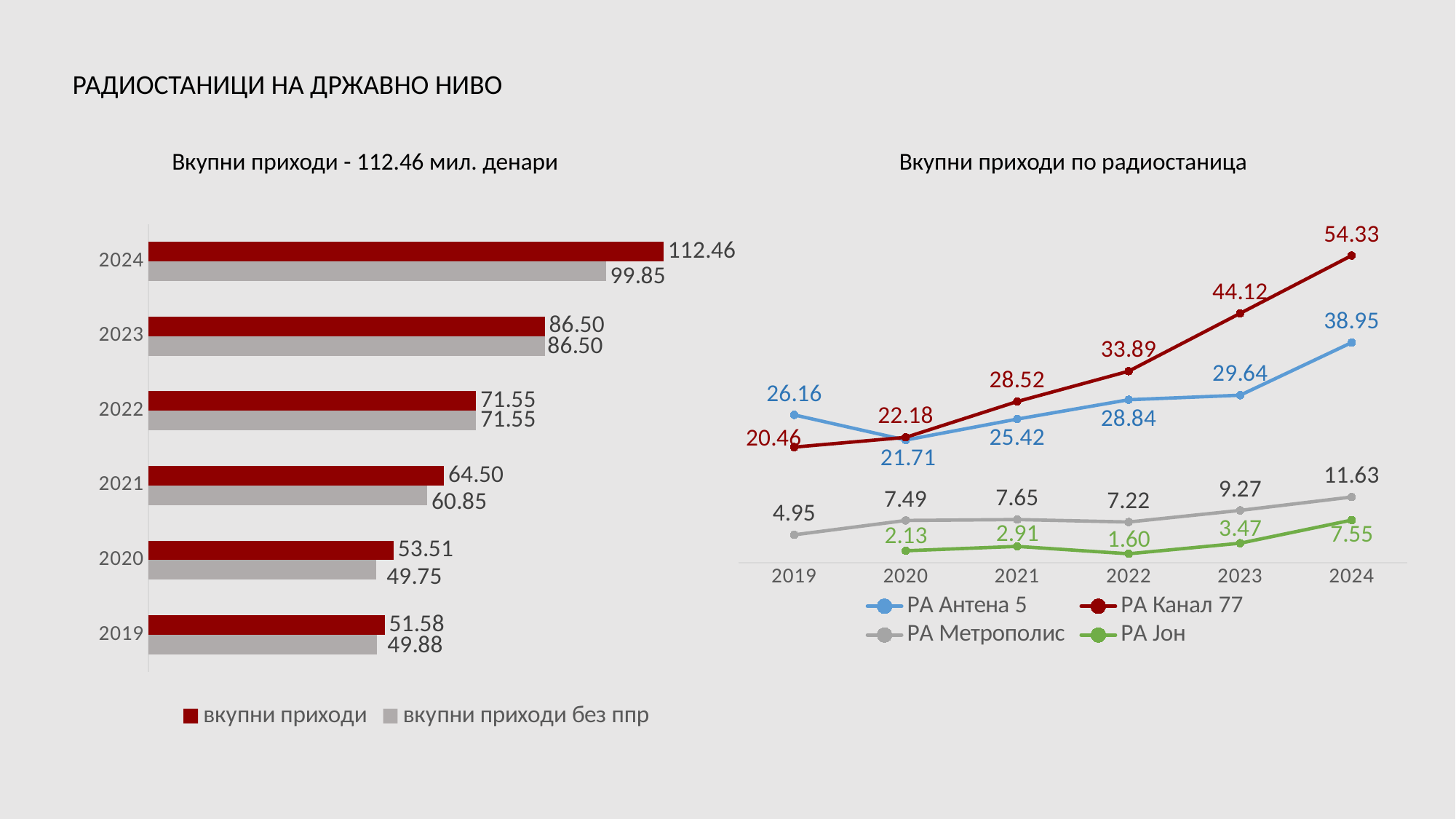
What kind of chart is the chart titled 'Вкупни приходи - 112.46 мил. денари'? bar chart In the chart titled 'Вкупни приходи - 112.46 мил. денари', how many series does the legend list? 2 In the chart titled 'Вкупни приходи - 112.46 мил. денари', what is the difference between 'вкупни приходи' and 'вкупни приходи без ппр' for 2024? 12.61 In the chart titled 'Вкупни приходи - 112.46 мил. денари', what is the value of 'вкупни приходи без ппр' for 2021? 60.85 In the chart titled 'Вкупни приходи по радиостаница', which is larger in 2019: РА Антена 5 or РА Канал 77? РА Антена 5 In the chart titled 'Вкупни приходи по радиостаница', what is the difference between РА Канал 77 and РА Антена 5 in 2024? 15.38 In the chart titled 'Вкупни приходи по радиостаница', what is the value for РА Канал 77 in 2022? 33.89 In the chart titled 'Вкупни приходи - 112.46 мил. денари', which year has the lowest value of 'вкупни приходи'? 2019 In the chart titled 'Вкупни приходи по радиостаница', which radio station has the highest value in 2024? РА Канал 77 In the chart titled 'Вкупни приходи по радиостаница', how many series does the legend list? 4 In the chart titled 'Вкупни приходи по радиостаница', what is the value for РА Јон in 2023? 3.47 In the chart titled 'Вкупни приходи - 112.46 мил. денари', what is the value of 'вкупни приходи' for 2024? 112.46